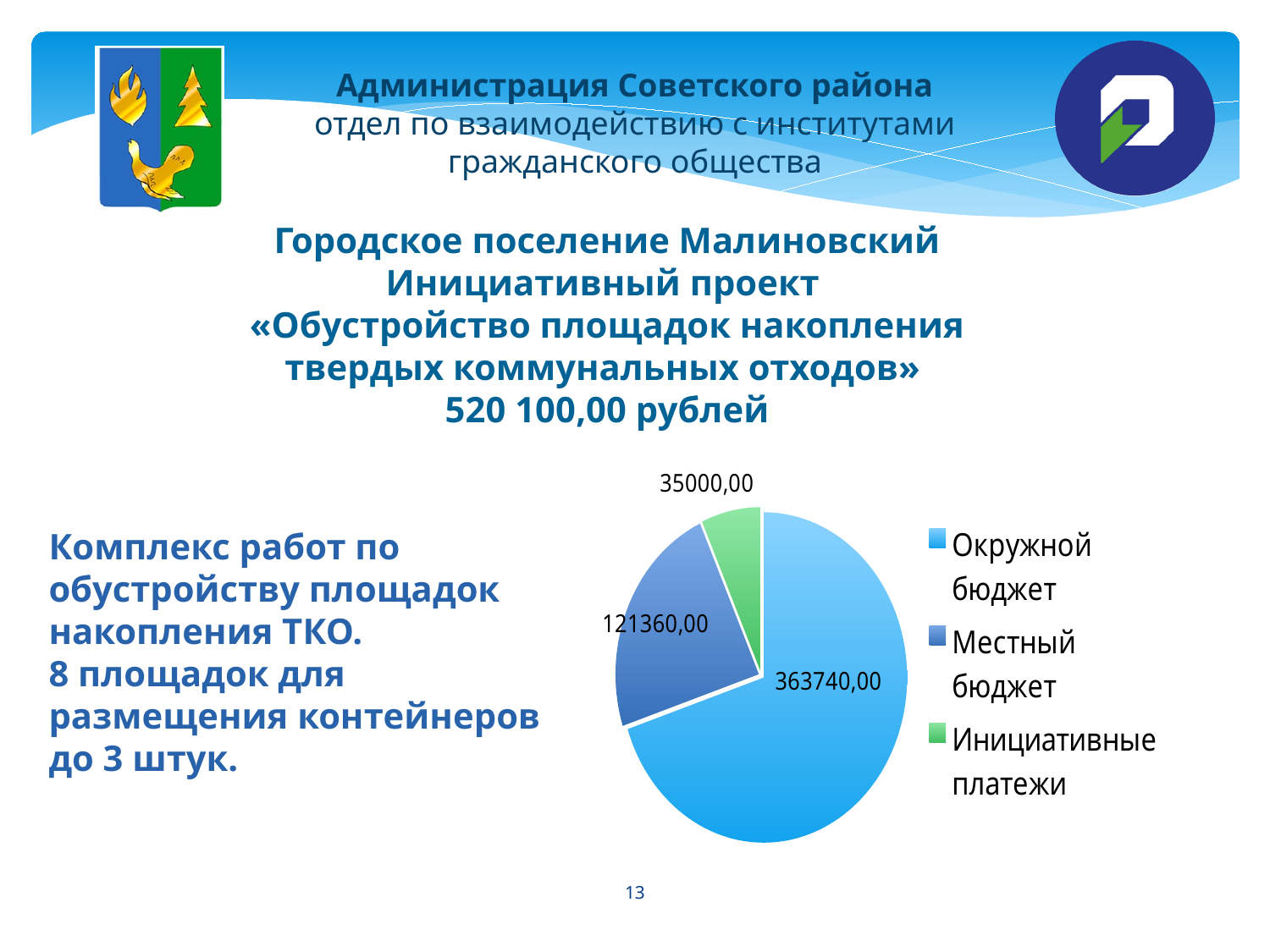
Which category has the smallest slice in the pie chart? Инициативные платежи Which colour represents Инициативные платежи in the pie chart? Green What is the value for Окружной бюджет in the pie chart? 363740,00 What is the total of all slices in the pie chart? 520100,00 What type of chart is shown on the slide? Pie chart How many slices does the pie chart have? 3 What is the difference between the values for Окружной бюджет and Местный бюджет? 242380,00 Which category has the largest slice in the pie chart? Окружной бюджет What is the value for Местный бюджет in the pie chart? 121360,00 What is the value for Инициативные платежи in the pie chart? 35000,00 Which is larger: Местный бюджет or Инициативные платежи? Местный бюджет What is the difference between the values for Местный бюджет and Инициативные платежи? 86360,00